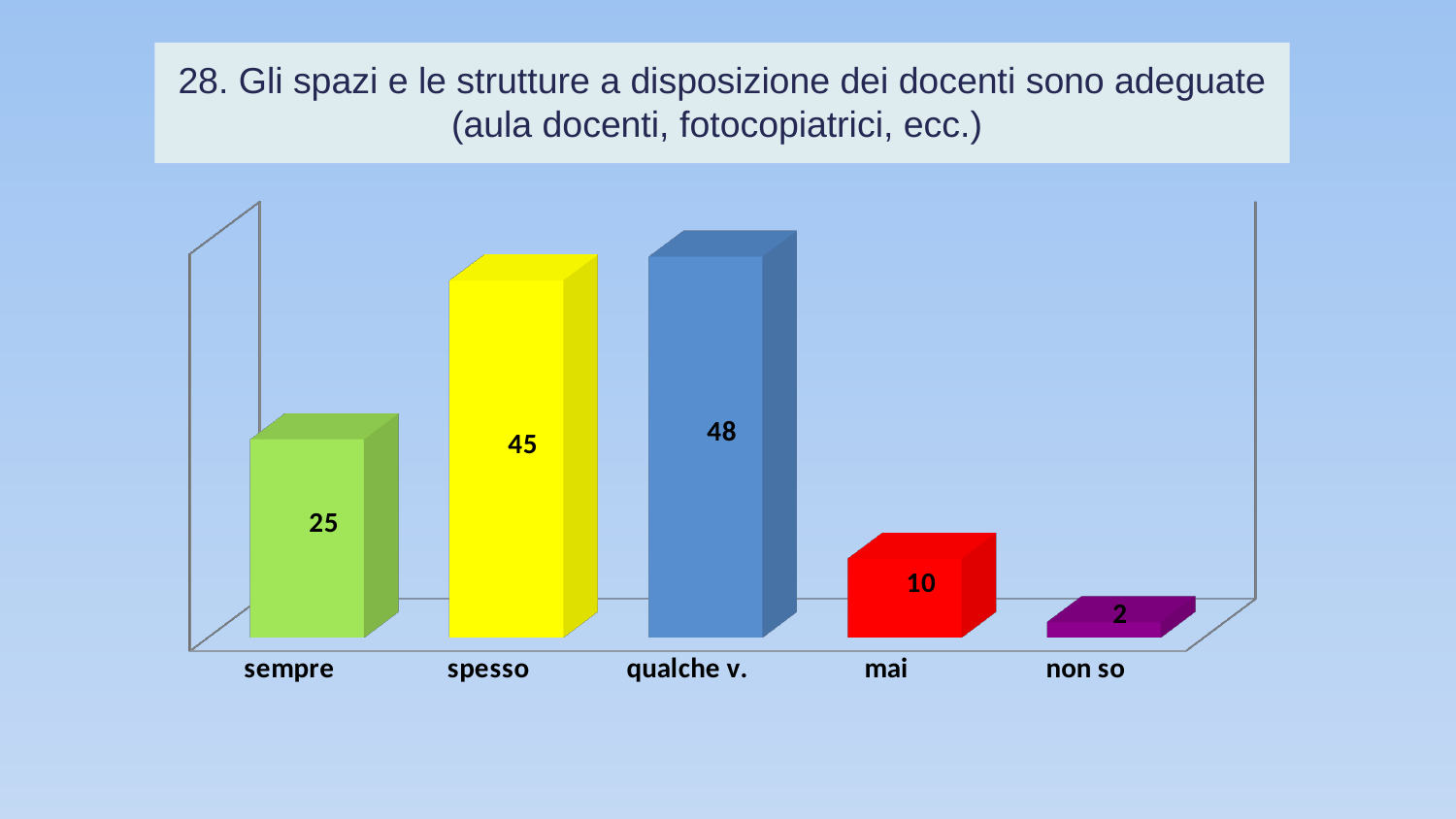
How many categories are shown in the chart? 5 What colour is the bar for "qualche v."? blue What is the value for "non so"? 2 What kind of chart is shown on the slide? bar chart Which category has the highest value? qualche v. Which is larger, the value for "sempre" or the value for "mai"? sempre Which category has the lowest value? non so What is the value for "sempre"? 25 What is the difference between the values for "spesso" and "sempre"? 20 What is the value for "spesso"? 45 What is the value for "mai"? 10 What is the value for "qualche v."? 48